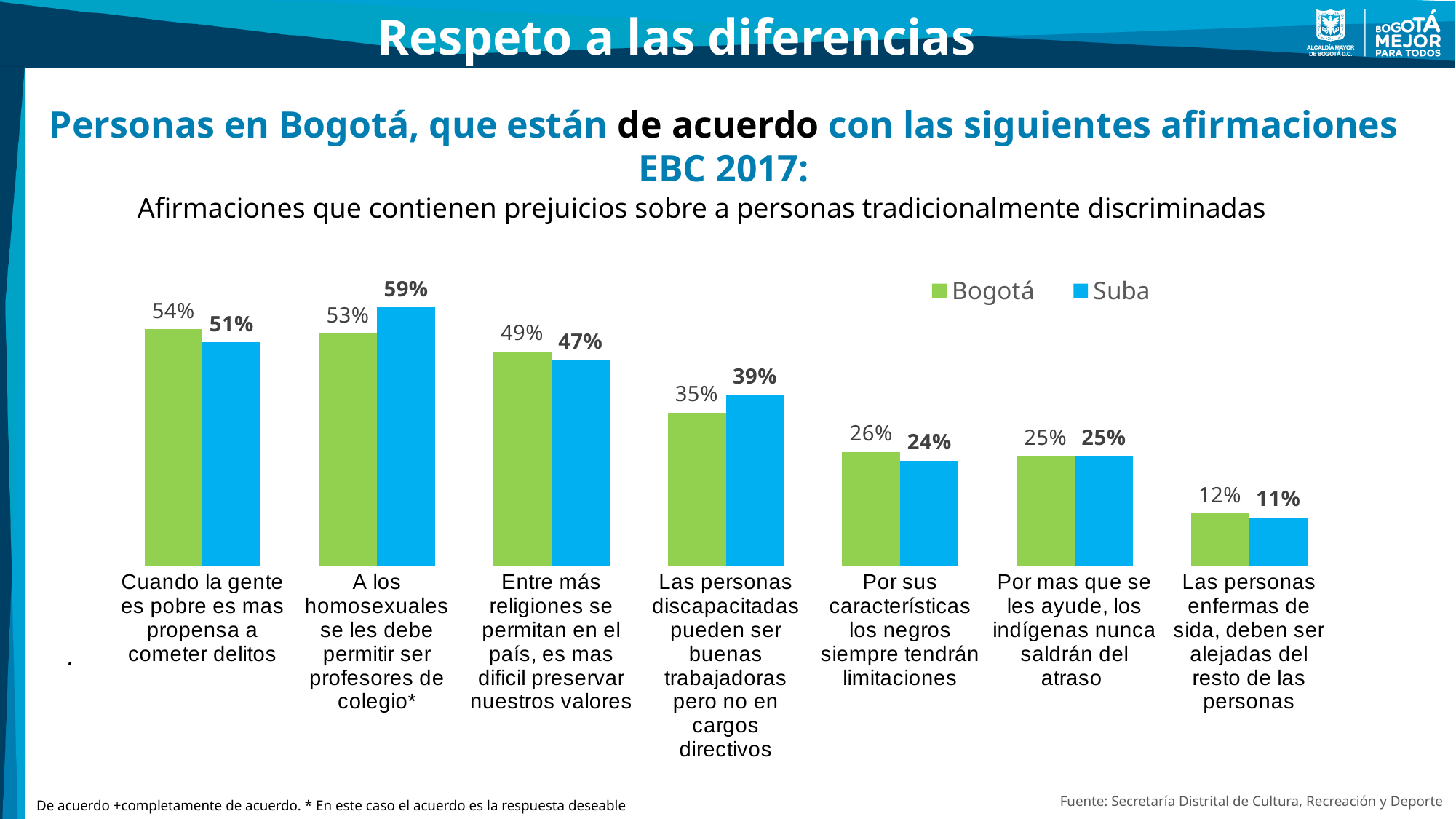
How many series does the legend list? 2 Which colour represents the Suba series in the chart? Blue How many categories (statements) are shown on the chart? 7 Which category has the lowest Bogotá value? Las personas enfermas de sida, deben ser alejadas del resto de las personas What kind of chart is shown on the slide? Bar chart Which category has the highest Suba value? A los homosexuales se les debe permitir ser profesores de colegio* What is the difference between the Suba and Bogotá values for "A los homosexuales se les debe permitir ser profesores de colegio*"? 6% Do the Bogotá values rise or fall from left to right across the categories? Fall Which is larger for "Entre más religiones se permitan en el país, es mas dificil preservar nuestros valores": the Bogotá value or the Suba value? Bogotá What is the Suba value for "A los homosexuales se les debe permitir ser profesores de colegio*"? 59% What is the Suba value for "Las personas discapacitadas pueden ser buenas trabajadoras pero no en cargos directivos"? 39% What is the Bogotá value for "Cuando la gente es pobre es mas propensa a cometer delitos"? 54%